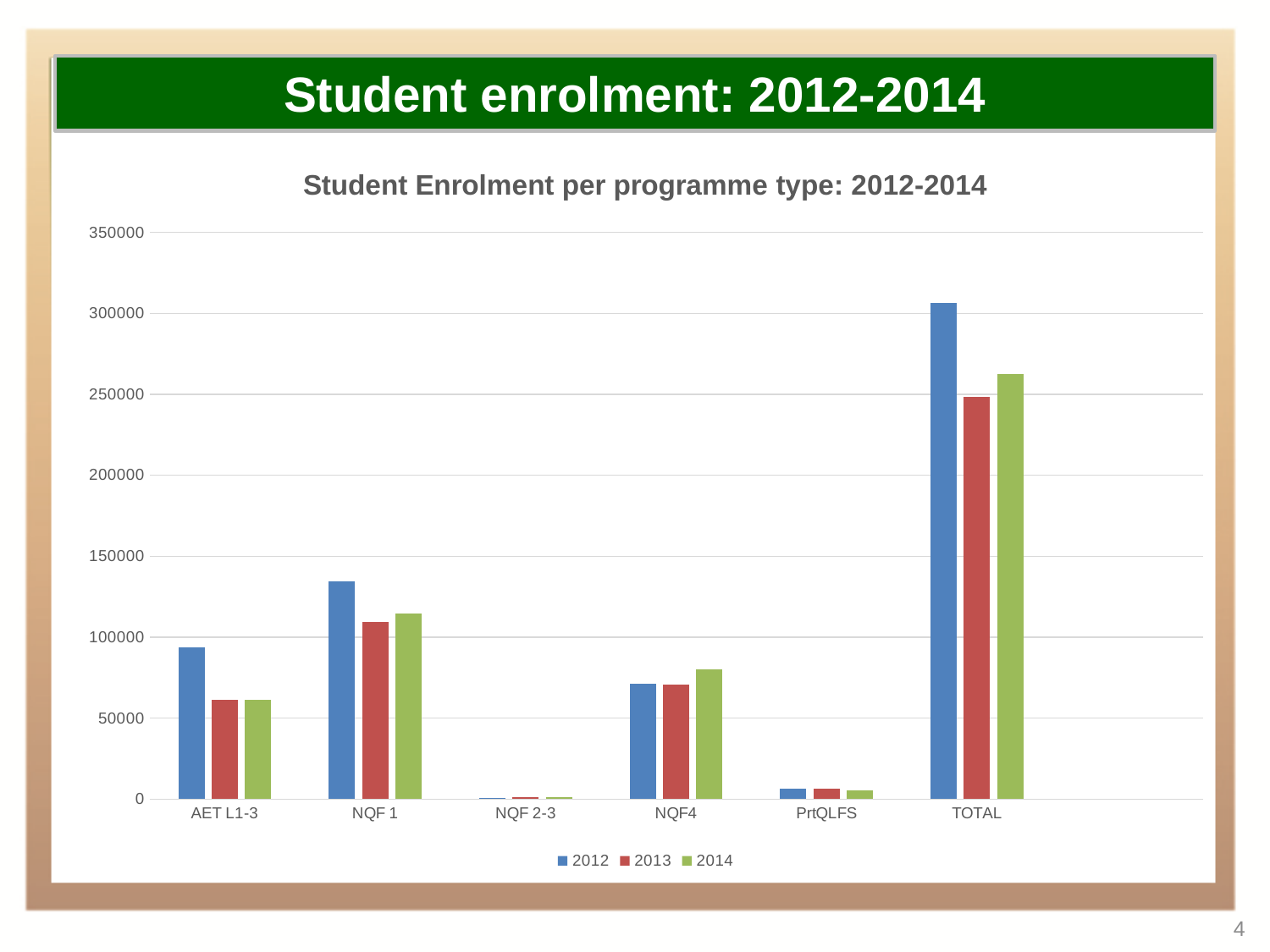
For NQF 1, does the value rise or fall from 2012 to 2013? fall For AET L1-3, which is larger: the 2012 value or the 2013 value? 2012 For TOTAL, which is larger: the 2013 value or the 2014 value? 2014 Which category has the lowest 2012 bar? NQF 2-3 What is the title of the chart? Student Enrolment per programme type: 2012-2014 Is the 2012 value for TOTAL greater or less than 300000? greater Which category has the highest 2012 bar? TOTAL How many categories are shown on the x axis? 6 Is the 2014 value for TOTAL greater or less than 250000? greater How many series does the legend list? 3 What kind of chart is shown on the slide? bar chart Is the 2012 value for NQF 1 greater or less than 100000? greater